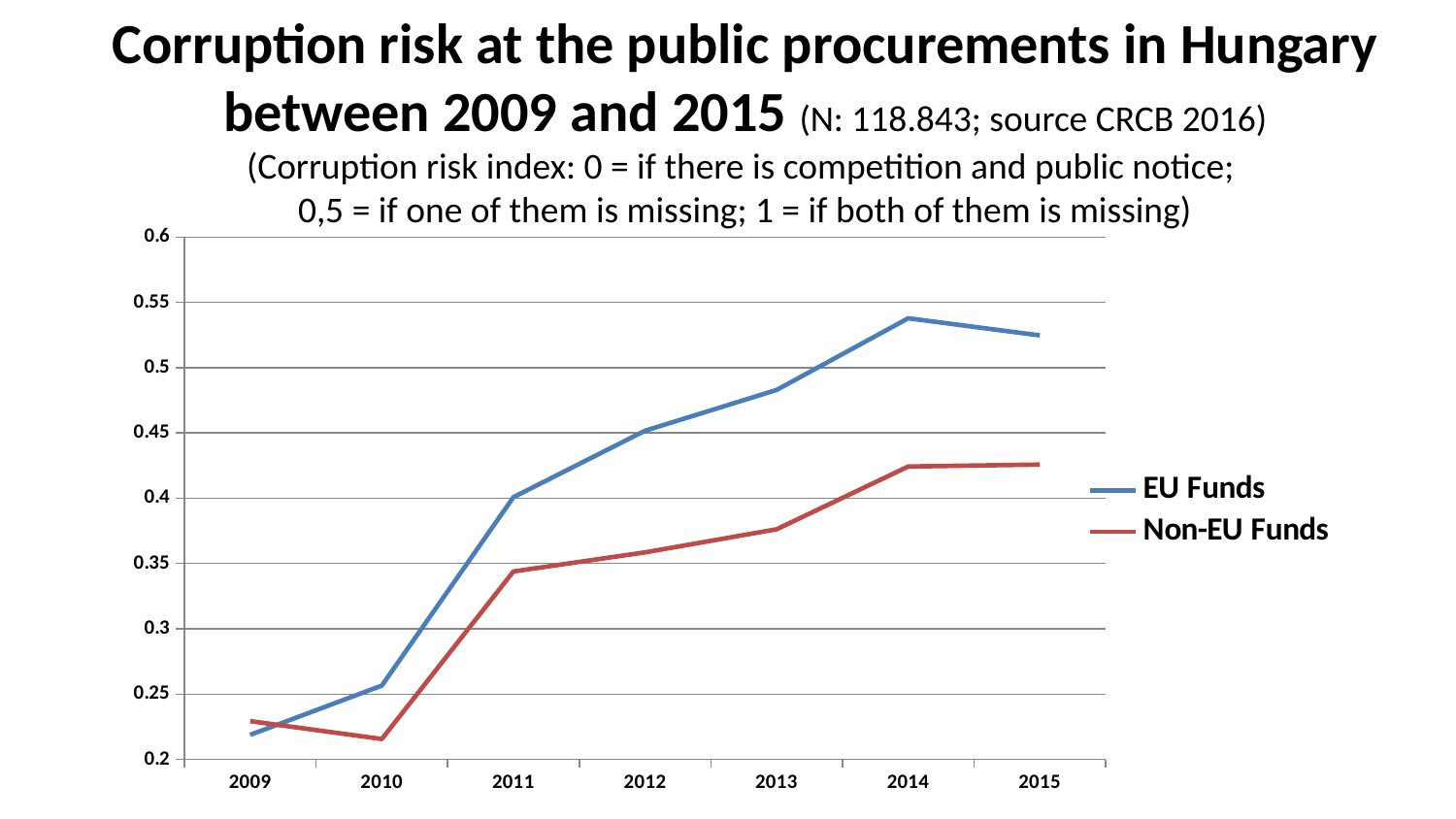
In which year is the EU Funds series at its lowest value? 2009 Is the value for EU Funds in 2010 greater or less than 0.3? less Does the EU Funds series rise or fall between 2010 and 2014? rise In which year does the EU Funds series reach its highest value? 2014 In which year is the Non-EU Funds series at its lowest value? 2010 How many series does the legend list? 2 What kind of chart is shown on the slide? line chart Is the value for EU Funds in 2014 greater or less than 0.5? greater Is the value for Non-EU Funds in 2014 greater or less than 0.4? greater In 2013, which series has the higher value, EU Funds or Non-EU Funds? EU Funds How many years are plotted along the x axis? 7